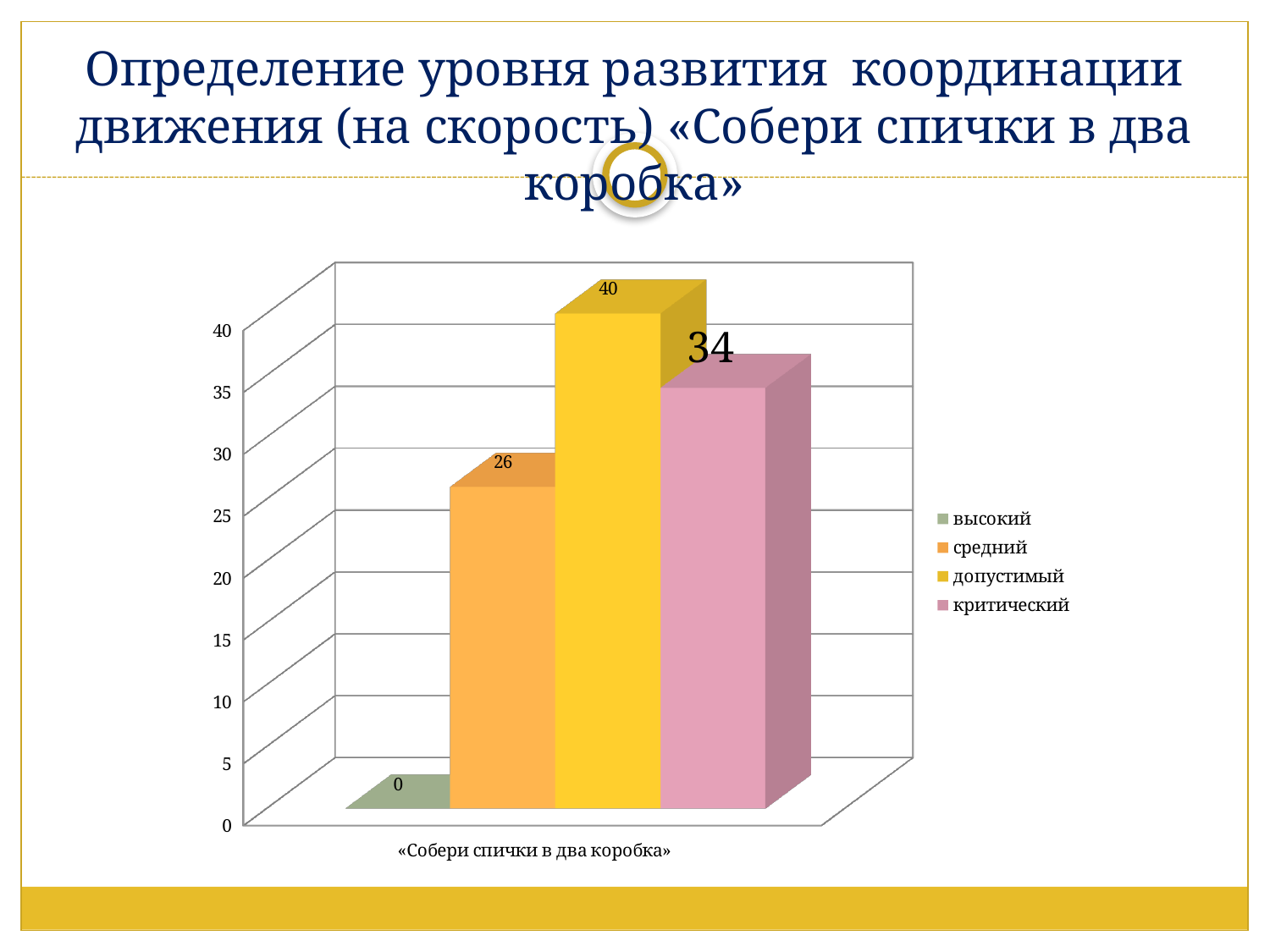
Which is larger, the value for «средний» or the value for «критический»? критический What is the value for the series «допустимый»? 40 What is the difference between the values for «критический» and «средний»? 8 What is the value for the series «средний»? 26 What is the value for the series «высокий»? 0 Which series has the lowest value? высокий What kind of chart is shown on the slide? bar chart Which series has the highest value? допустимый What is the category label shown on the x axis of the chart? «Собери спички в два коробка» What is the value for the series «критический»? 34 How many series does the legend list? 4 What is the difference between the values for «допустимый» and «критический»? 6